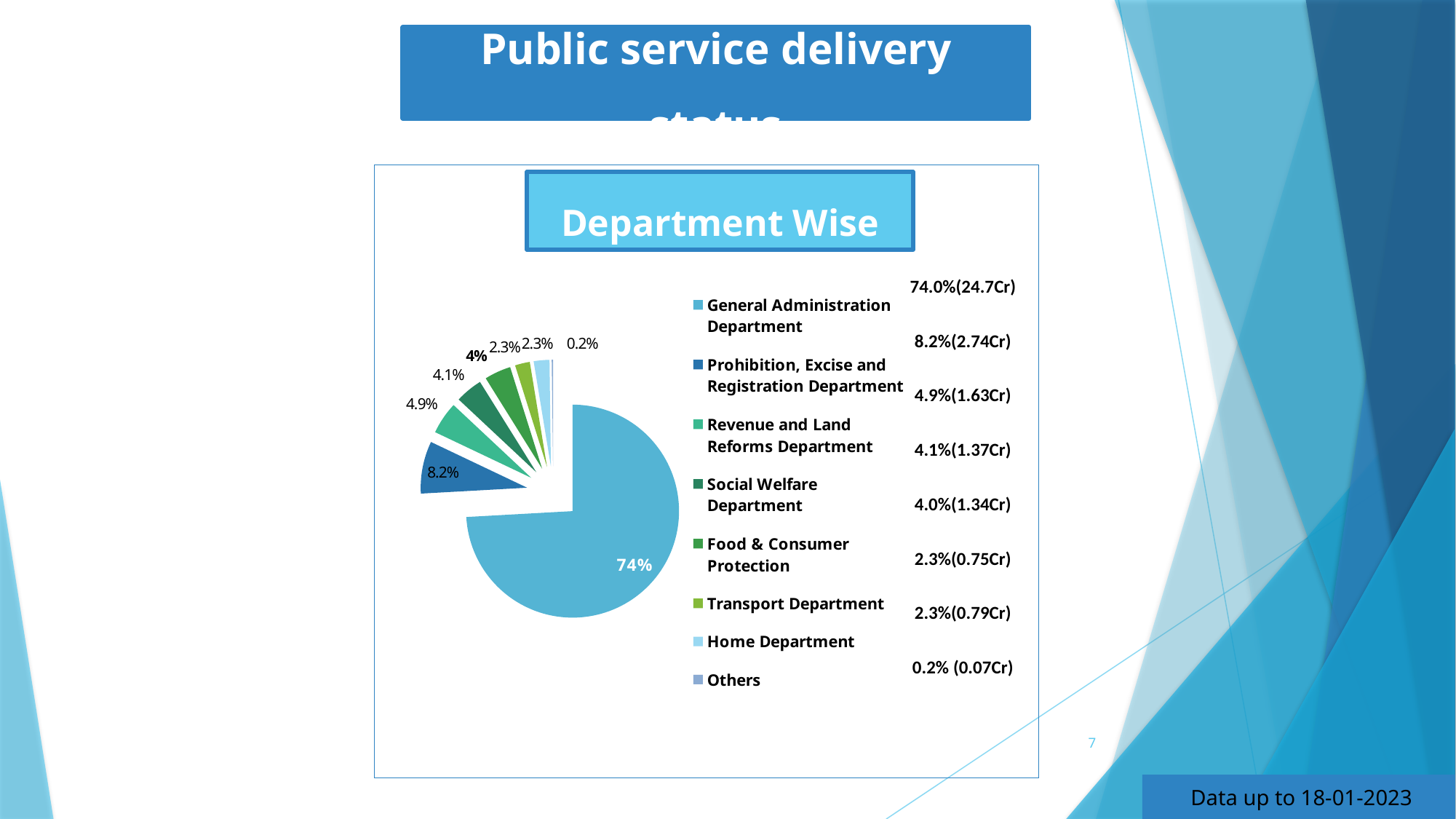
What kind of chart is shown on the slide? pie chart What is the percentage shown for the Social Welfare Department? 4.1% What share of the pie does the General Administration Department have? 74% Which category has the smallest share in the Department Wise pie chart? Others How many departments (slices) does the Department Wise pie chart show? 8 What is the percentage shown for the Revenue and Land Reforms Department? 4.9% Which department has the largest share in the Department Wise pie chart? General Administration Department What is the percentage shown for Others? 0.2% Which has the larger share: the Revenue and Land Reforms Department or the Social Welfare Department? Revenue and Land Reforms Department What is the title shown above the pie chart? Department Wise What is the percentage shown for the Prohibition, Excise and Registration Department? 8.2% What is the difference in percentage points between the General Administration Department (74%) and the Prohibition, Excise and Registration Department (8.2%)? 65.8 percentage points